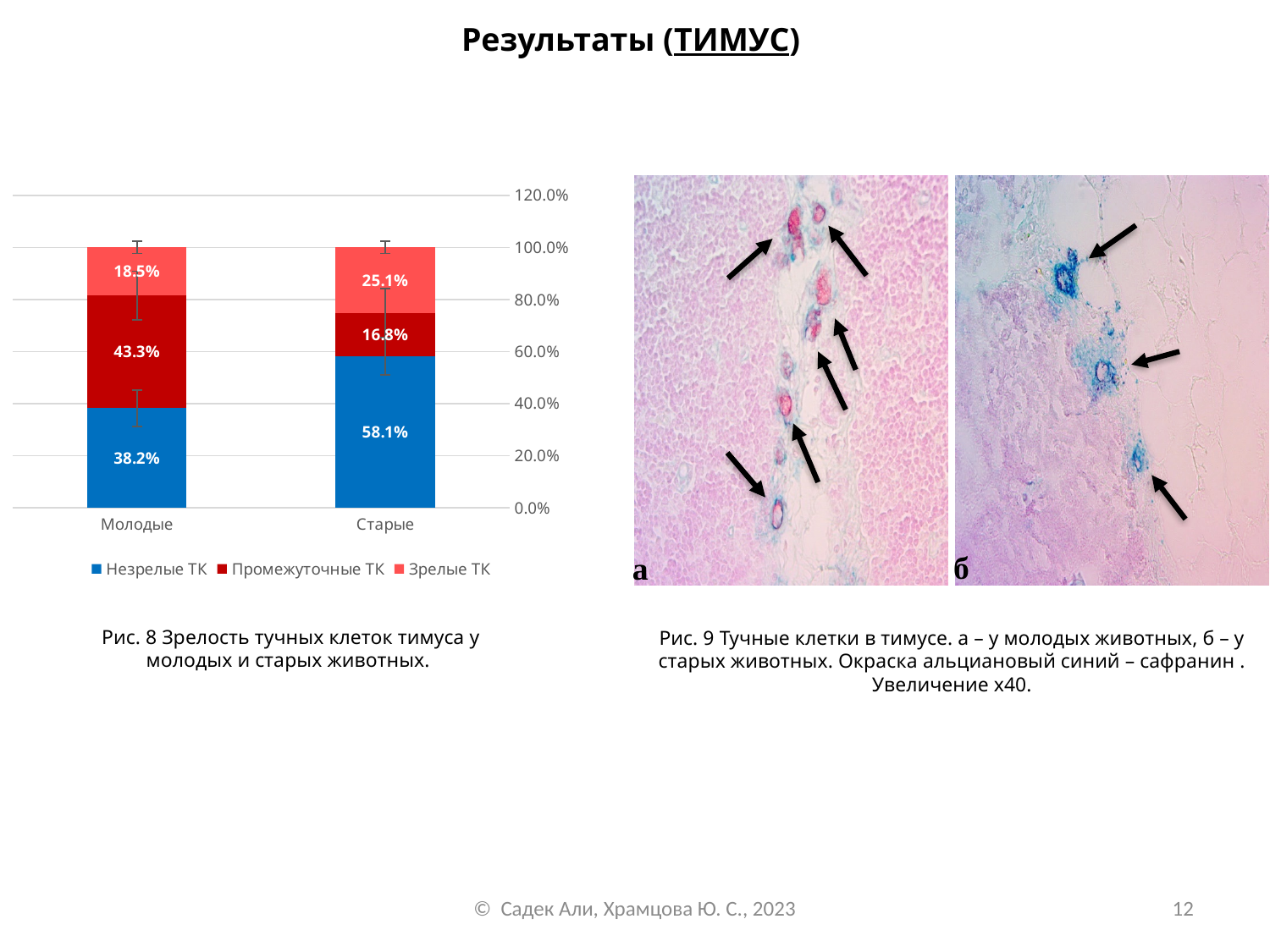
How many categories are shown on the x axis? 2 What is the total of the stacked bar for Молодые? 100.0% Which category has the higher value for Промежуточные ТК, Молодые or Старые? Молодые What is the value for Незрелые ТК in the Молодые category? 38.2% What type of chart is shown on the slide? Stacked bar chart What is the value for Незрелые ТК in the Старые category? 58.1% How many series does the legend list? 3 What is the difference between the Зрелые ТК values for Старые and Молодые? 6.6% Which category has the higher value for Незрелые ТК, Молодые or Старые? Старые What is the value for Промежуточные ТК in the Старые category? 16.8% What is the value for Зрелые ТК in the Молодые category? 18.5% What is the difference between the Незрелые ТК values for Старые and Молодые? 19.9%